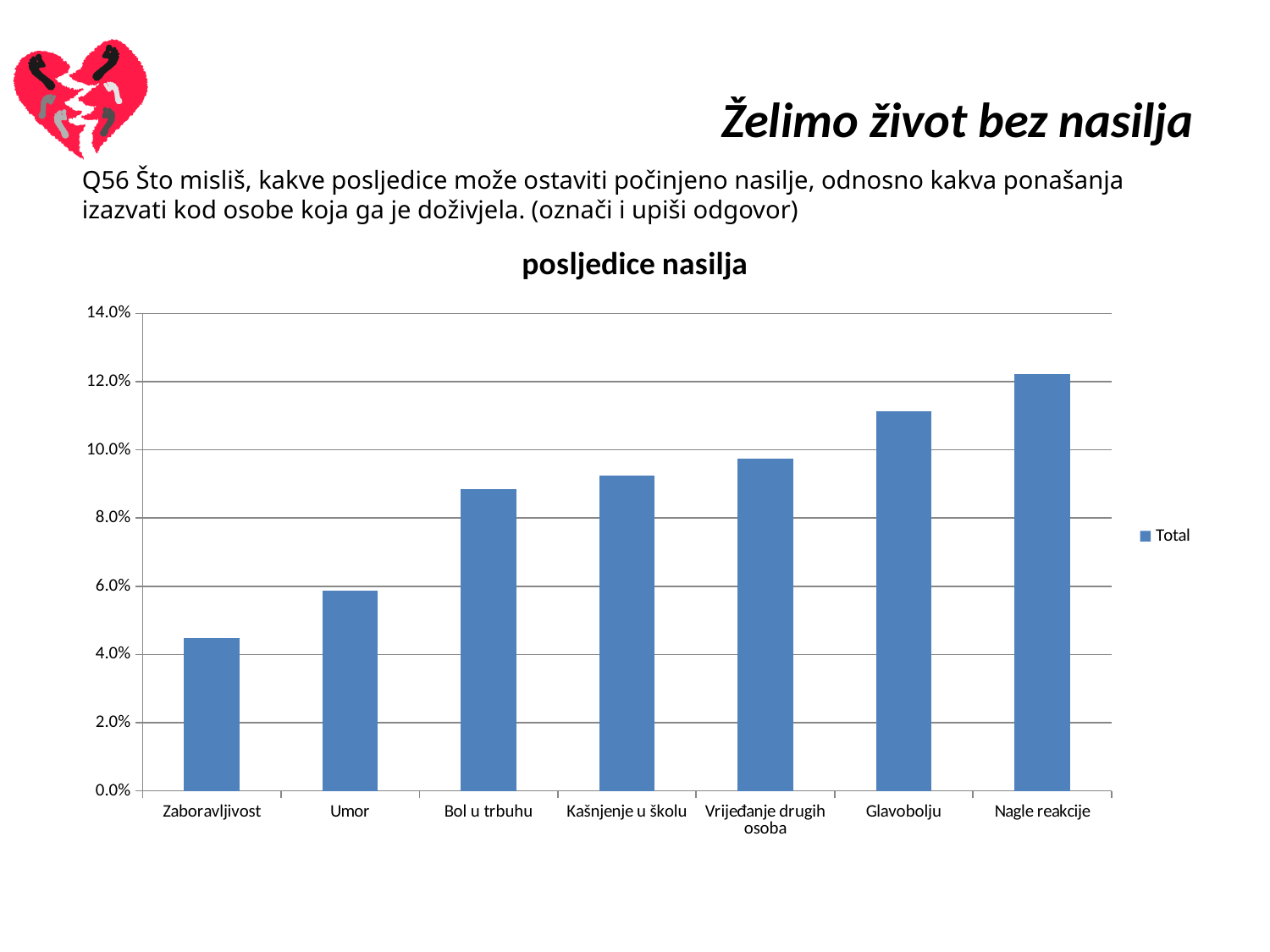
Is the value for Nagle reakcije greater or less than 12.0%? greater How many categories are shown on the x axis of the chart? 7 Do the values rise or fall from left to right along the x axis? rise Which is larger, the value for Glavobolju or the value for Bol u trbuhu? Glavobolju What is the title of the chart? posljedice nasilja What is the name of the series in the legend? Total Is the value for Zaboravljivost greater or less than 4.0%? greater Which category has the highest value? Nagle reakcije Is the value for Umor greater or less than 6.0%? less Which category has the lowest value? Zaboravljivost What type of chart is shown on the slide? bar chart How many series does the legend list? 1